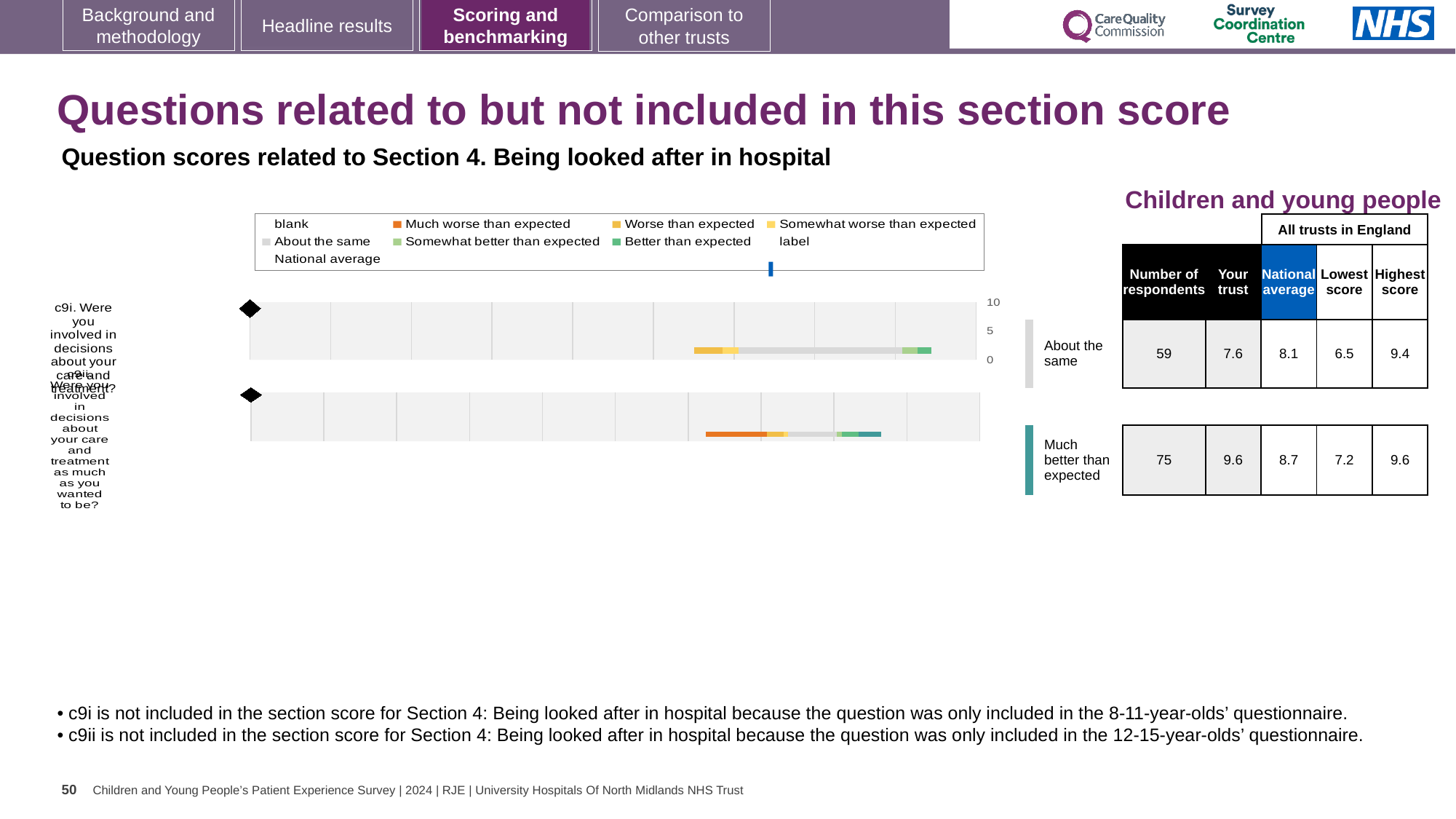
By how much does the 'Your trust' score for c9ii exceed the national average for c9ii? 0.9 What is the lowest score among all trusts in England for question c9ii? 7.2 Which question has the higher 'Your trust' score, c9i or c9ii? c9ii How many questions are plotted in the chart? 2 What benchmark category is shown for question c9ii? Much better than expected What is the 'Your trust' score for question c9i? 7.6 What is the difference between the national average and the 'Your trust' score for question c9i? 0.5 What is the highest score among all trusts in England for question c9i? 9.4 What is the national average score for question c9ii? 8.7 How many respondents answered question c9i? 59 What kind of chart is used to show the question scores for c9i and c9ii? bar chart What benchmark category is shown for question c9i? About the same